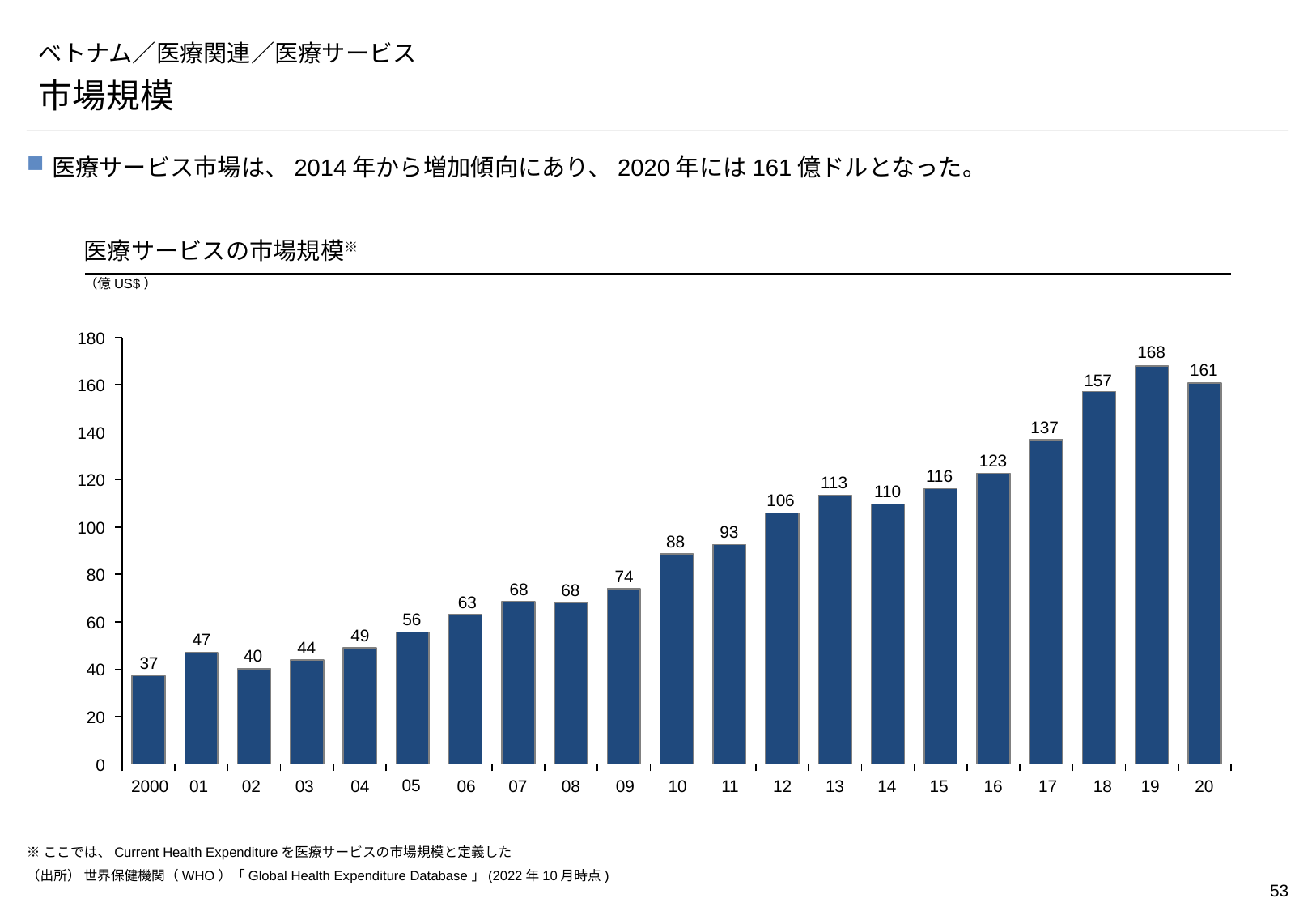
Which year has the lowest value in the chart? 2000 Do the values generally rise or fall from 2000 to 2019? Rise What is the difference between the values for 2018 and 2017? 20 What is the value for 2000 in the chart? 37 What kind of chart is shown on the slide? Bar chart What is the value for 2020 in the 医療サービスの市場規模 chart? 161 What unit is shown for the chart's values? 億 US$ How many years (bars) are shown in the chart? 21 Which year has the highest value in the chart? 19 Which is larger, the value for 2013 or the value for 2014? 2013 What is the difference between the values for 2019 and 2020? 7 What is the value for 2014 in the chart? 110